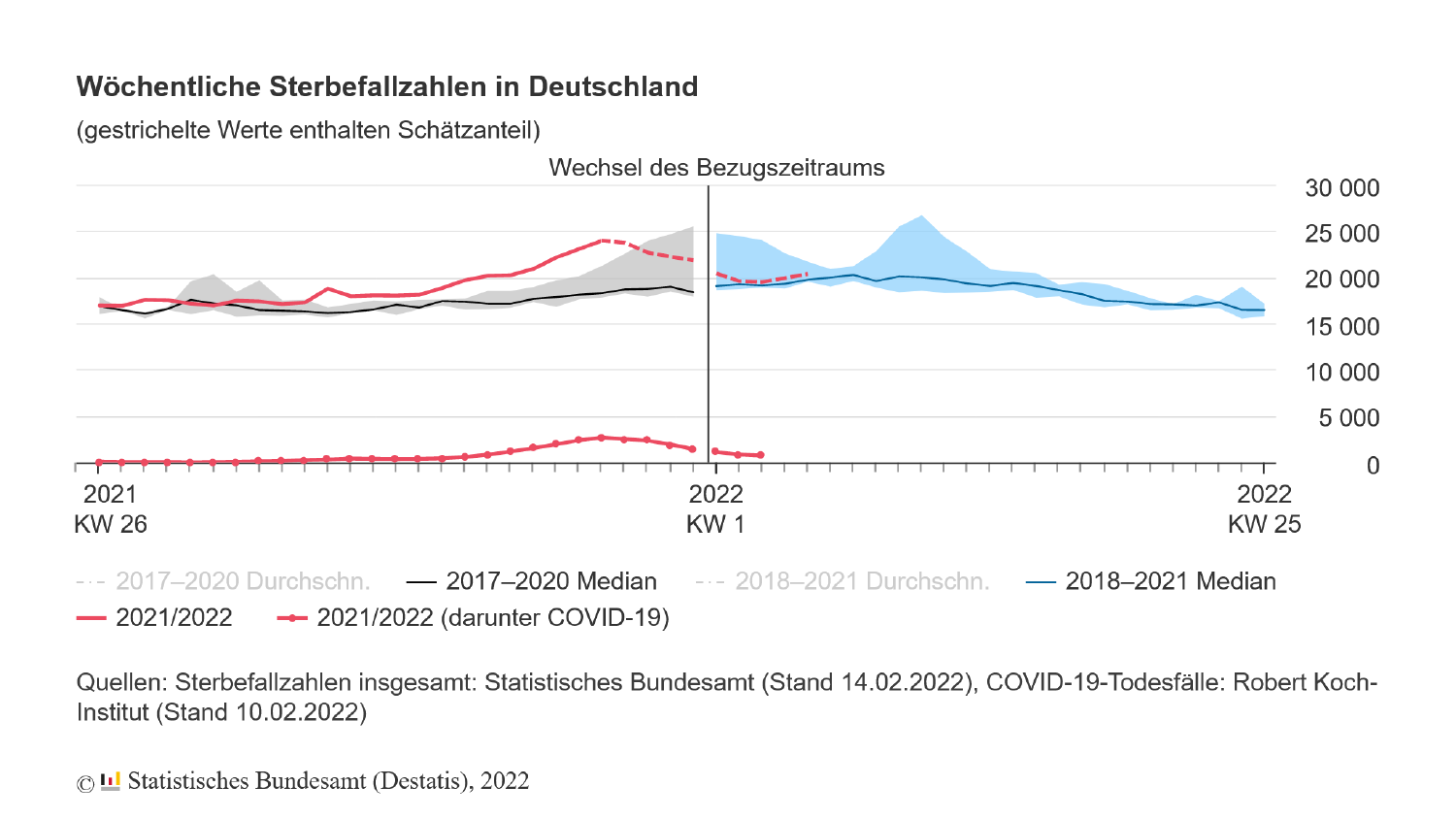
Is the value of the 2017–2020 Median line at 2021 KW 26 greater or less than 15 000? greater Is the value of the 2018–2021 Median line at 2022 KW 25 greater or less than 20 000? less What is the highest value shown on the y axis? 30 000 What does the label at the vertical line in the middle of the chart say? Wechsel des Bezugszeitraums What kind of chart is shown on the slide? line chart Is the highest value of the 2021/2022 (darunter COVID-19) line greater or less than 5 000? less Does the 2021/2022 (darunter COVID-19) line rise or fall between 2021 KW 26 and its peak near the end of 2021? rise How many series does the legend list? 6 At the end of 2021 (just before 2022 KW 1), which line is higher: 2021/2022 or 2017–2020 Median? 2021/2022 What is the title of the chart? Wöchentliche Sterbefallzahlen in Deutschland